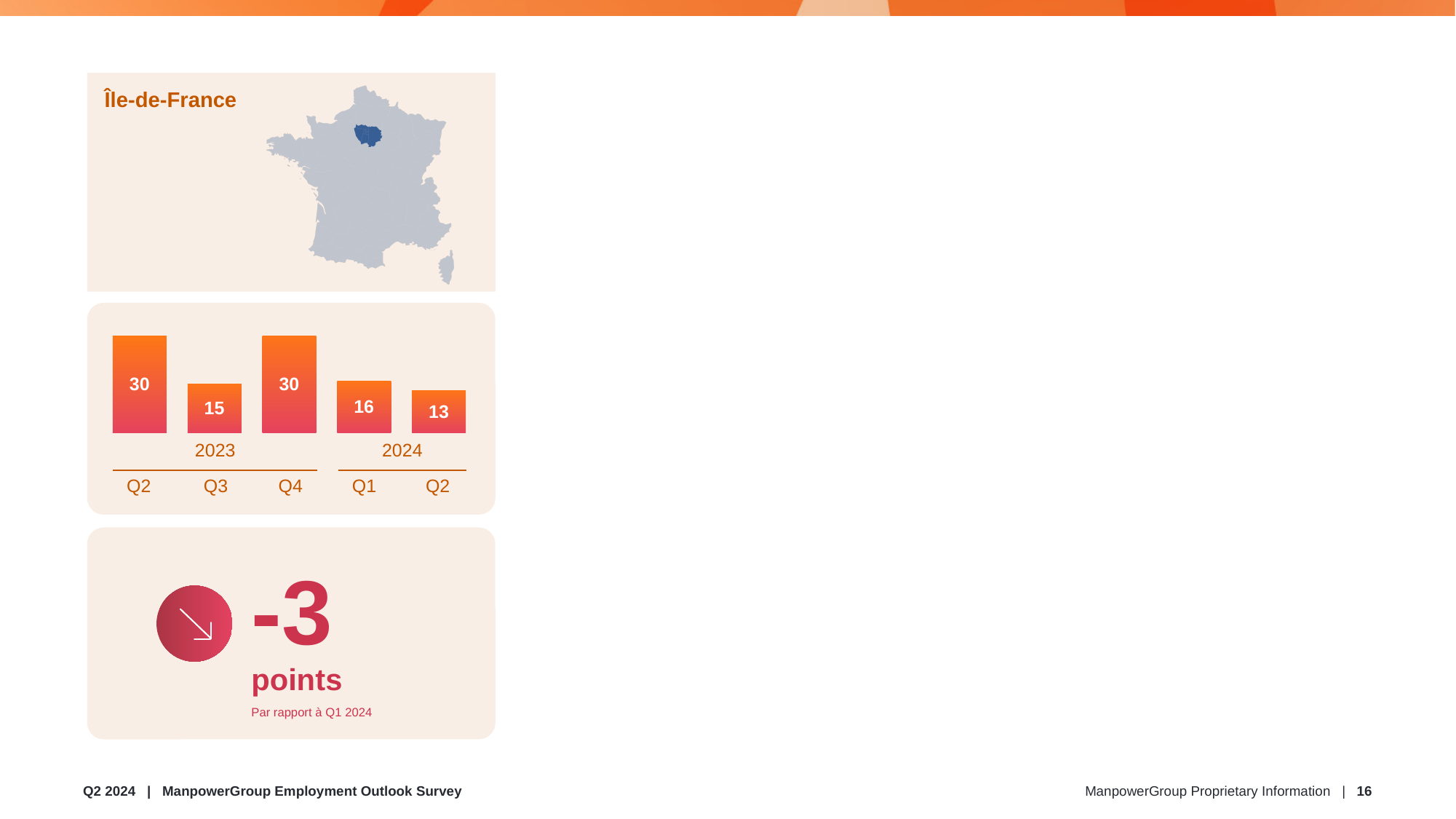
What is the value for Q2 2024 in the Île-de-France bar chart? 13 What change in points compared to Q1 2024 is highlighted on the slide for Île-de-France? -3 points Which is larger in the Île-de-France bar chart, the value for Q3 2023 or Q1 2024? Q1 2024 What is the value for Q3 2023 in the Île-de-France bar chart? 15 Do the values in the Île-de-France bar chart rise or fall from Q1 2024 to Q2 2024? Fall What kind of chart is used to show the quarterly values for Île-de-France? Bar chart How many quarters are shown in the Île-de-France bar chart? 5 Which quarter has the lowest value in the Île-de-France bar chart? Q2 2024 What is the value for Q1 2024 in the Île-de-France bar chart? 16 What is the difference between the Q4 2023 and Q3 2023 values in the Île-de-France bar chart? 15 What is the difference between the Q1 2024 and Q2 2024 values in the Île-de-France bar chart? 3 What is the value for Q2 2023 in the Île-de-France bar chart? 30